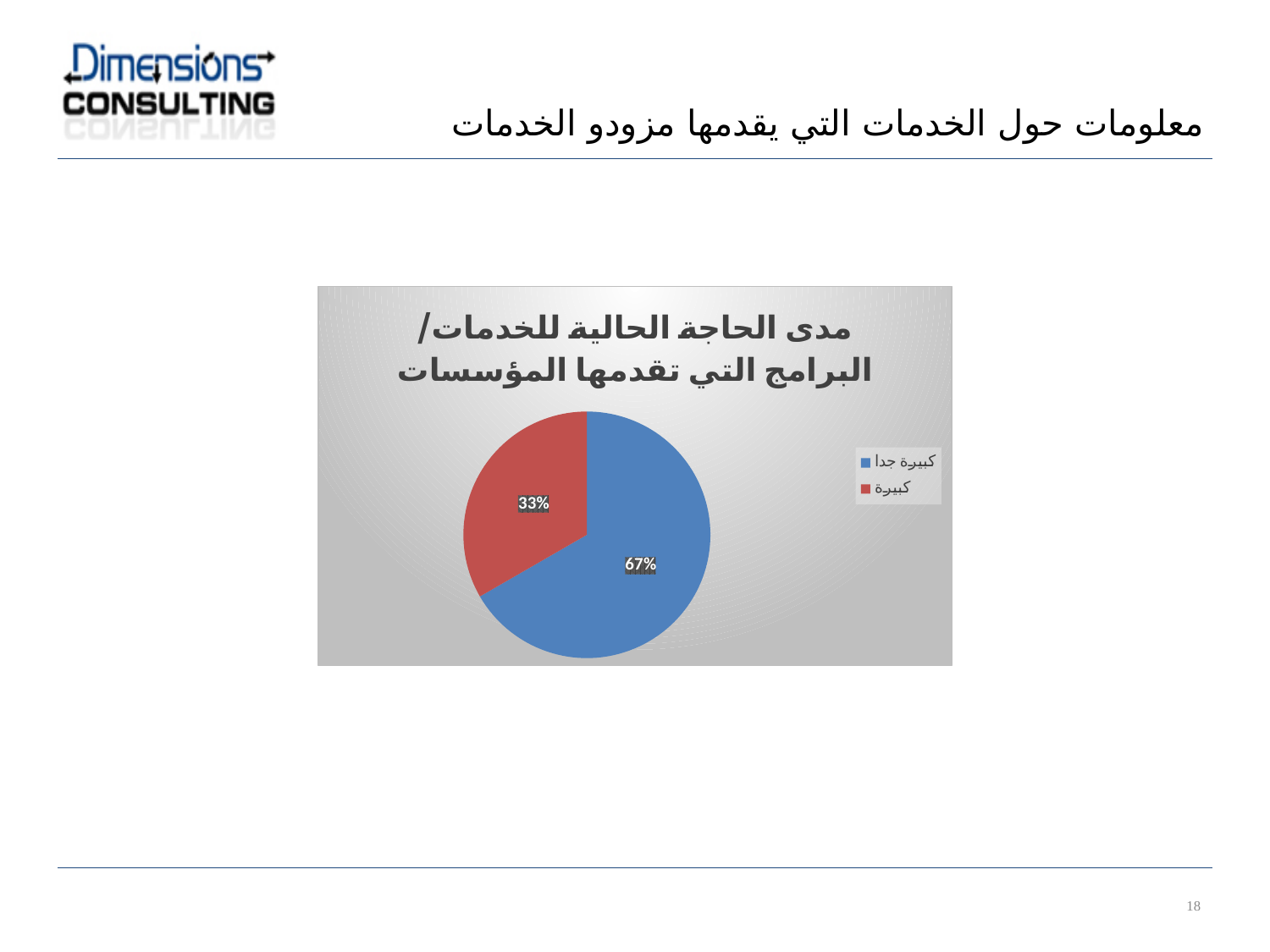
What colour is the 'كبيرة' slice? red Which slice is larger, 'كبيرة جدا' or 'كبيرة'? كبيرة جدا What share of the pie does the 'كبيرة جدا' slice represent? 67% How many entries does the legend list? 2 What kind of chart is shown on the slide? pie chart Which category has the largest slice of the pie? كبيرة جدا What is the difference in percentage points between the 'كبيرة جدا' and 'كبيرة' slices? 34% What is the title of the chart? مدى الحاجة الحالية للخدمات/ البرامج التي تقدمها المؤسسات Which category has the smallest slice of the pie? كبيرة How many slices does the pie chart have? 2 What share of the pie does the 'كبيرة' slice represent? 33%